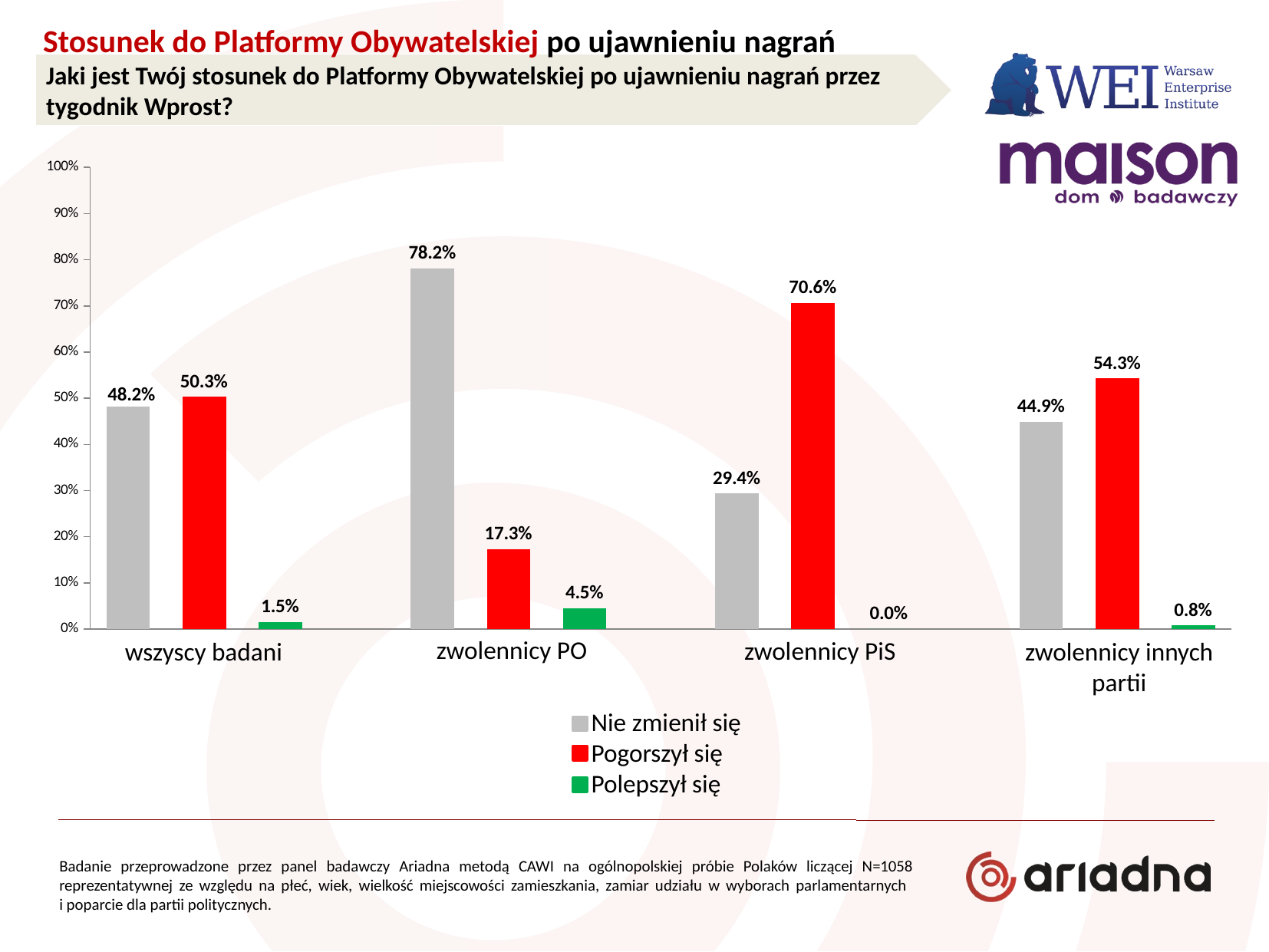
Which category has the highest value for "Pogorszył się"? zwolennicy PiS What is the value of "Nie zmienił się" for "zwolennicy PO"? 78.2% Which colour represents "Polepszył się" in the chart? green Which category has the lowest value for "Polepszył się"? zwolennicy PiS What is the value of "Polepszył się" for "wszyscy badani"? 1.5% How many categories are shown on the x axis? 4 How many series does the legend list? 3 What is the value of "Pogorszył się" for "zwolennicy PiS"? 70.6% Is the value of "Nie zmienił się" for "zwolennicy PiS" greater or less than 30%? less What kind of chart is shown on the slide? bar chart For "zwolennicy PO", which is larger: "Pogorszył się" or "Polepszył się"? Pogorszył się What is the difference between "Pogorszył się" and "Nie zmienił się" for "zwolennicy innych partii"? 9.4%